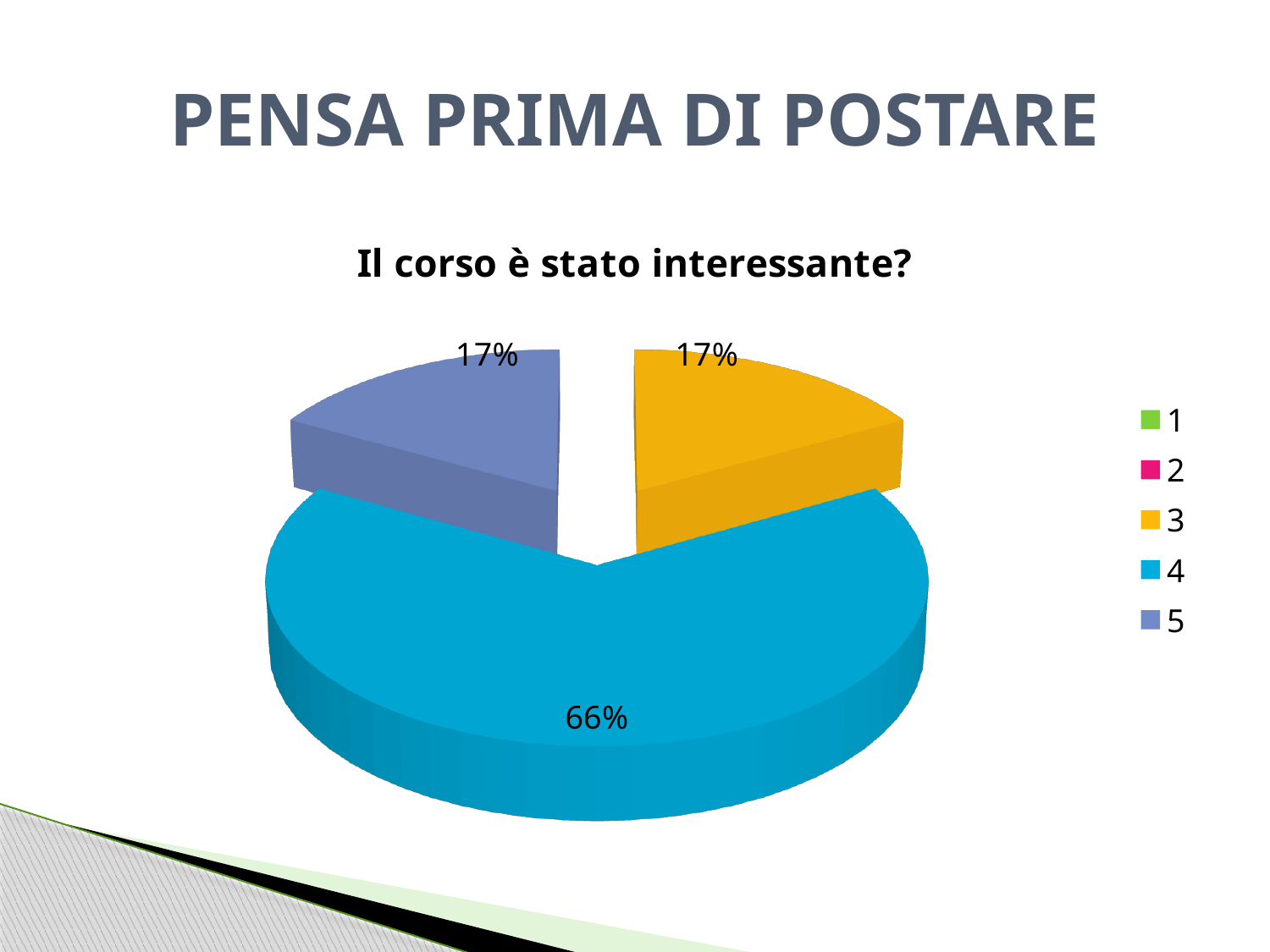
How many slices are visible in the pie? 3 What kind of chart is shown on the slide? pie chart What share of the pie does category 4 represent? 66% Is the share for category 4 greater or less than 50%? greater Which category has the largest slice of the pie? 4 What is the title of the chart? Il corso è stato interessante? What colour is the slice for category 4? cyan (light blue) What share of the pie does category 5 represent? 17% How many entries does the chart legend list? 5 What share of the pie does category 3 represent? 17% What is the difference between the share for category 4 and the share for category 5? 49% Which is larger, the slice for category 4 or the slice for category 3? 4